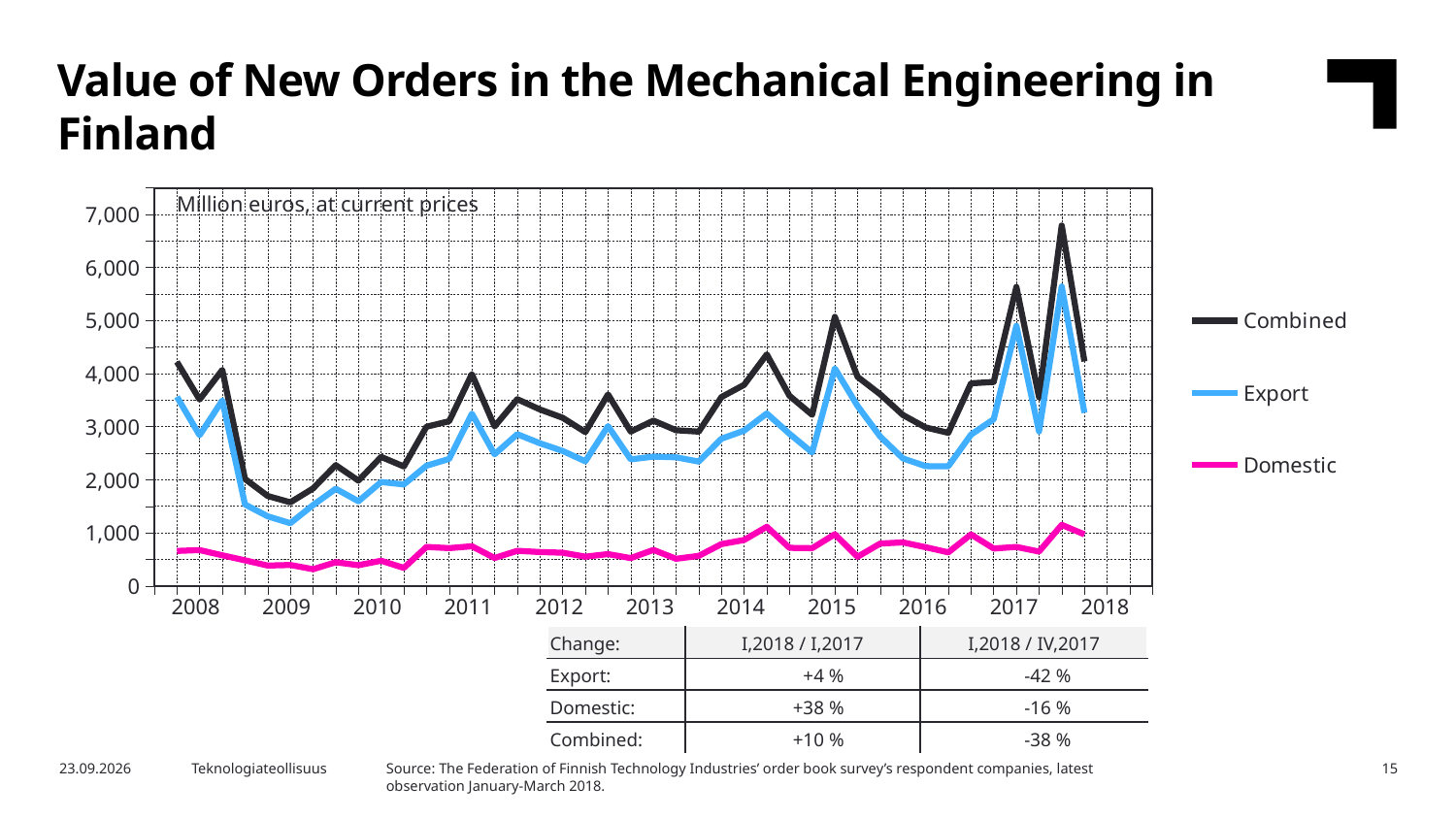
Which series has the lowest values throughout the chart? Domestic How many series does the chart's legend list? 3 What unit is stated at the top of the chart? Million euros, at current prices Is the value of the Domestic series in 2008 greater or less than 1,000? less According to the change table below the chart, what is the Domestic change for I,2018 / I,2017? +38 % Which series is plotted with the pink line? Domestic What kind of chart is shown on the slide? Line chart Is the peak value of the Combined series in 2017 greater or less than 6,000? greater Does the Combined series rise or fall from the start of 2008 to the start of 2009? fall In 2014, which is larger, the Export value or the Domestic value? Export Is the value of the Export series at the start of 2009 greater or less than 2,000? less Which series has the highest values throughout the chart? Combined